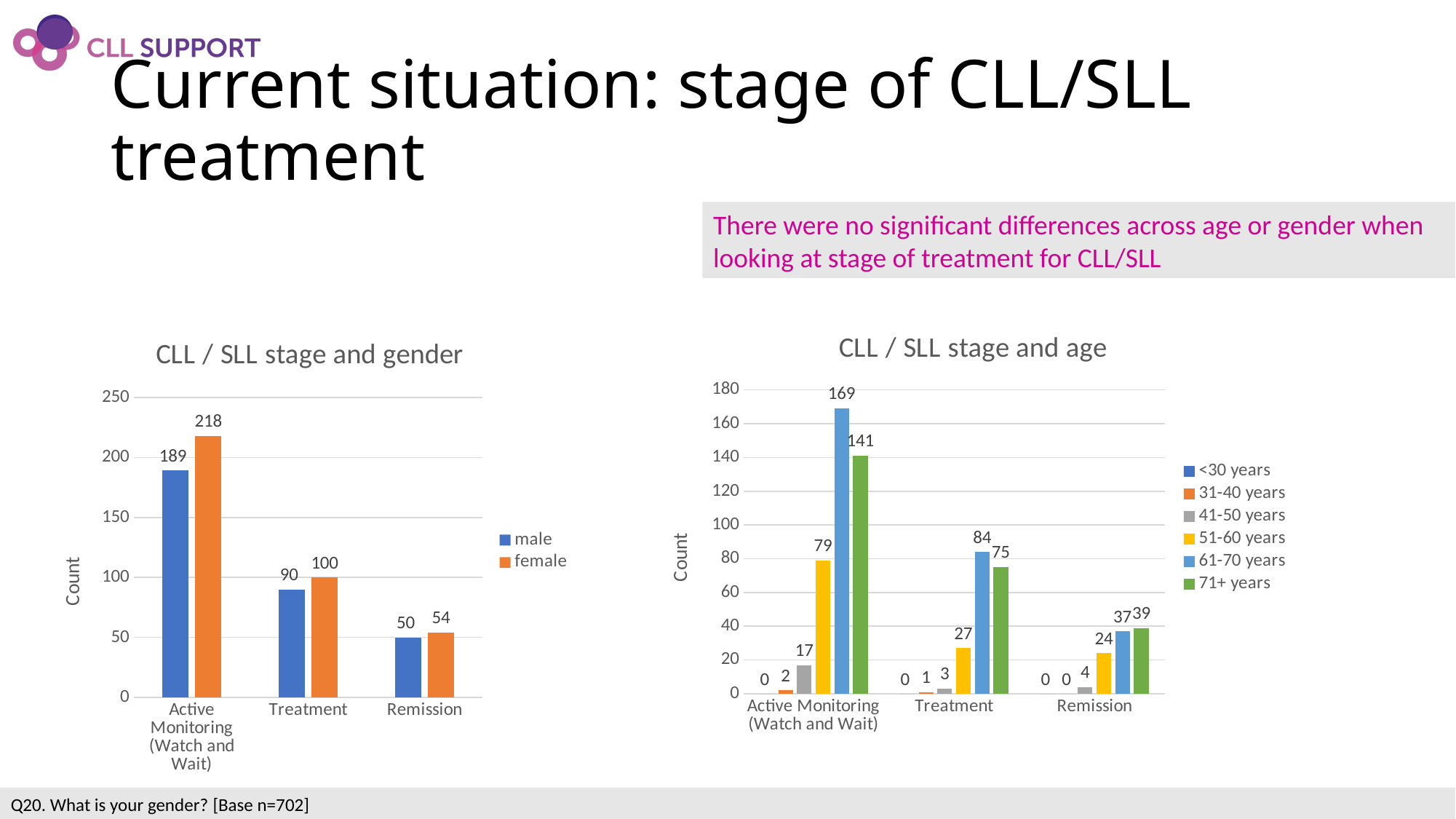
What kind of chart is the 'CLL / SLL stage and age' chart? bar chart In the 'CLL / SLL stage and age' chart, what is the difference between the 61-70 years and 71+ years values for Active Monitoring (Watch and Wait)? 28 In the 'CLL / SLL stage and age' chart, which age group has the lowest value in Remission? <30 years and 31-40 years (both 0) In the 'CLL / SLL stage and age' chart, what is the value for 61-70 years in Active Monitoring (Watch and Wait)? 169 In the 'CLL / SLL stage and gender' chart, how many series does the legend list? 2 In the 'CLL / SLL stage and gender' chart, what is the value for male in Treatment? 90 In the 'CLL / SLL stage and age' chart, how many series does the legend list? 6 In the 'CLL / SLL stage and gender' chart, which category has the highest male value? Active Monitoring (Watch and Wait) In the 'CLL / SLL stage and age' chart, what is the value for 51-60 years in Treatment? 27 In the 'CLL / SLL stage and gender' chart, what is the difference between the female and male values for Remission? 4 In the 'CLL / SLL stage and gender' chart, what is the value for female in Active Monitoring (Watch and Wait)? 218 In the 'CLL / SLL stage and age' chart, is the value for 61-70 years in Treatment larger or smaller than the value for 71+ years in Treatment? larger